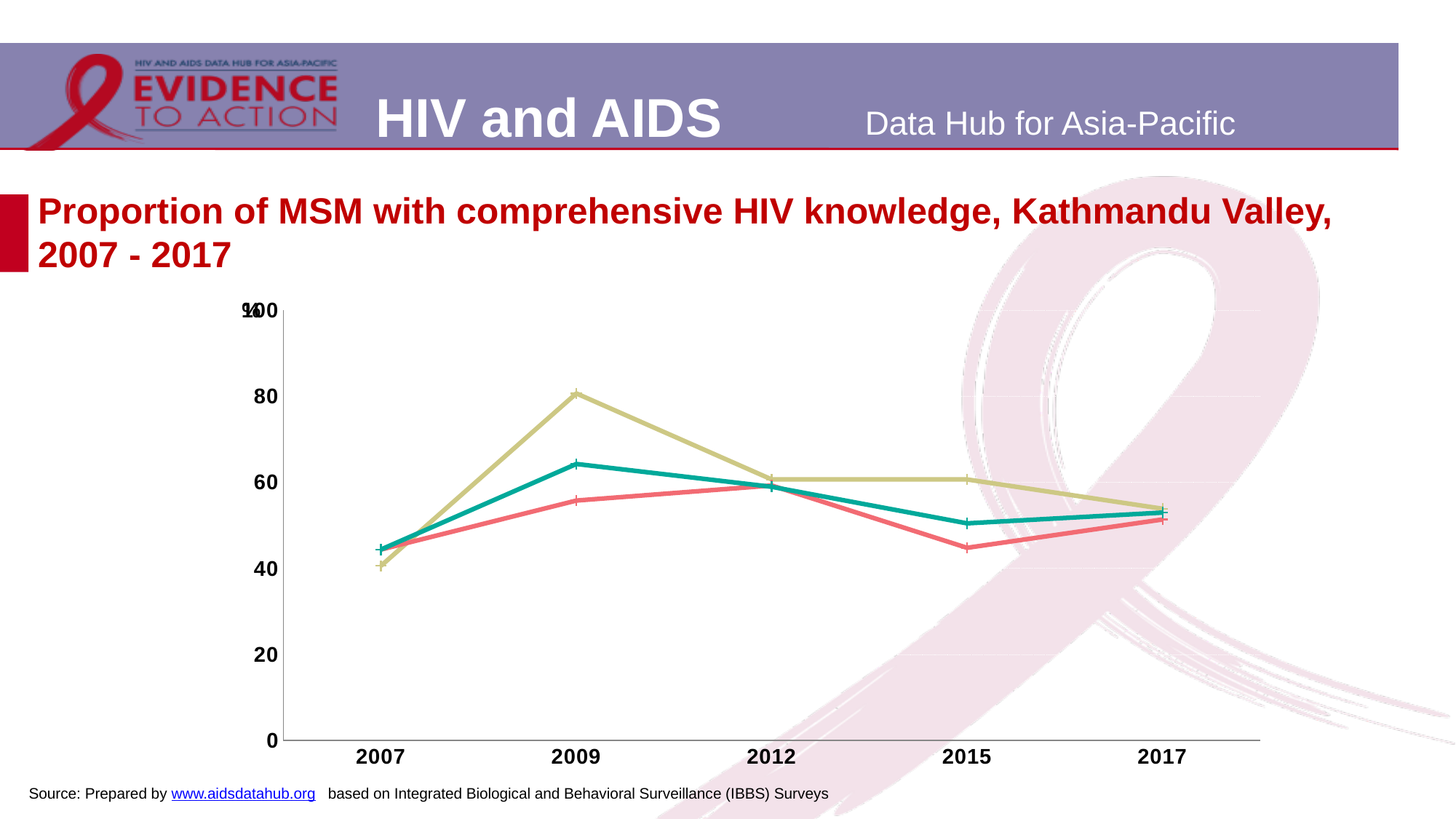
Is the value of the yellow line in 2009 greater or less than 70? greater Is the value of the teal line in 2007 greater or less than 60? less Does the yellow line rise or fall from 2009 to 2017? fall In 2009, which line is higher, the yellow line or the teal line? yellow line How many years are plotted along the x axis of the chart? 5 Is the value of the red line in 2015 greater or less than 60? less What is the title of the chart on the slide? Proportion of MSM with comprehensive HIV knowledge, Kathmandu Valley, 2007 - 2017 In which year does the teal line reach its highest value? 2009 In which year does the yellow line reach its highest value? 2009 What unit is shown on the y axis of the chart? % In which year is the yellow line at its lowest value? 2007 What type of chart is shown on the slide? line chart